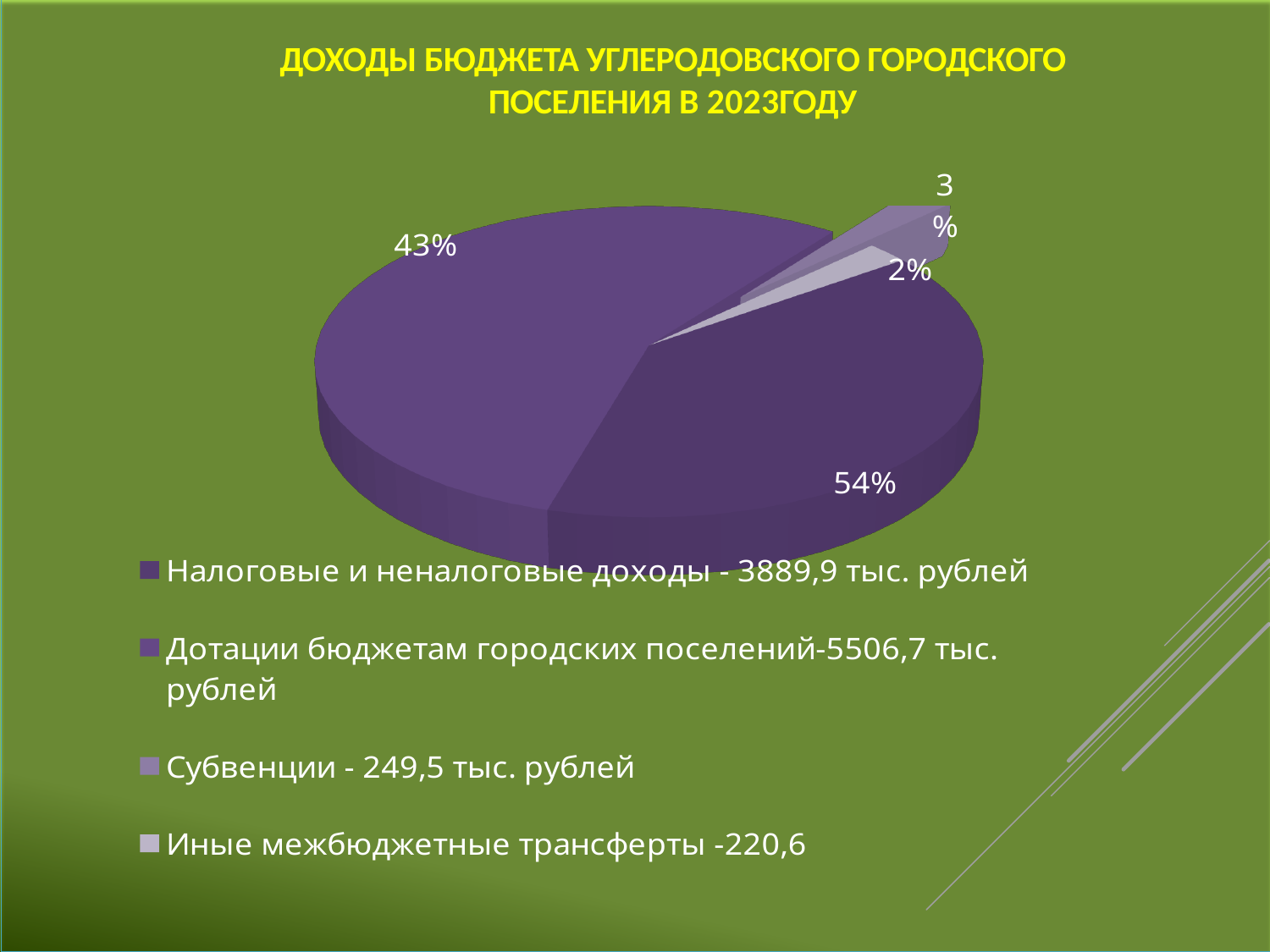
What share of the pie is labelled for Иные межбюджетные трансферты? 2% What kind of chart is shown on the slide? pie chart How many entries does the legend list? 4 What is the title of the chart on the slide? ДОХОДЫ БЮДЖЕТА УГЛЕРОДОВСКОГО ГОРОДСКОГО ПОСЕЛЕНИЯ В 2023ГОДУ What share of the pie is labelled for Субвенции? 3% How many slices does the pie chart have? 4 Which category has the smallest slice of the pie? Иные межбюджетные трансферты What share of the pie is labelled for Дотации бюджетам городских поселений? 54% Which category has the largest slice of the pie? Дотации бюджетам городских поселений By how many percentage points does the Дотации slice exceed the Налоговые и неналоговые доходы slice? 11 What amount does the legend give for Субвенции? 249,5 тыс. рублей